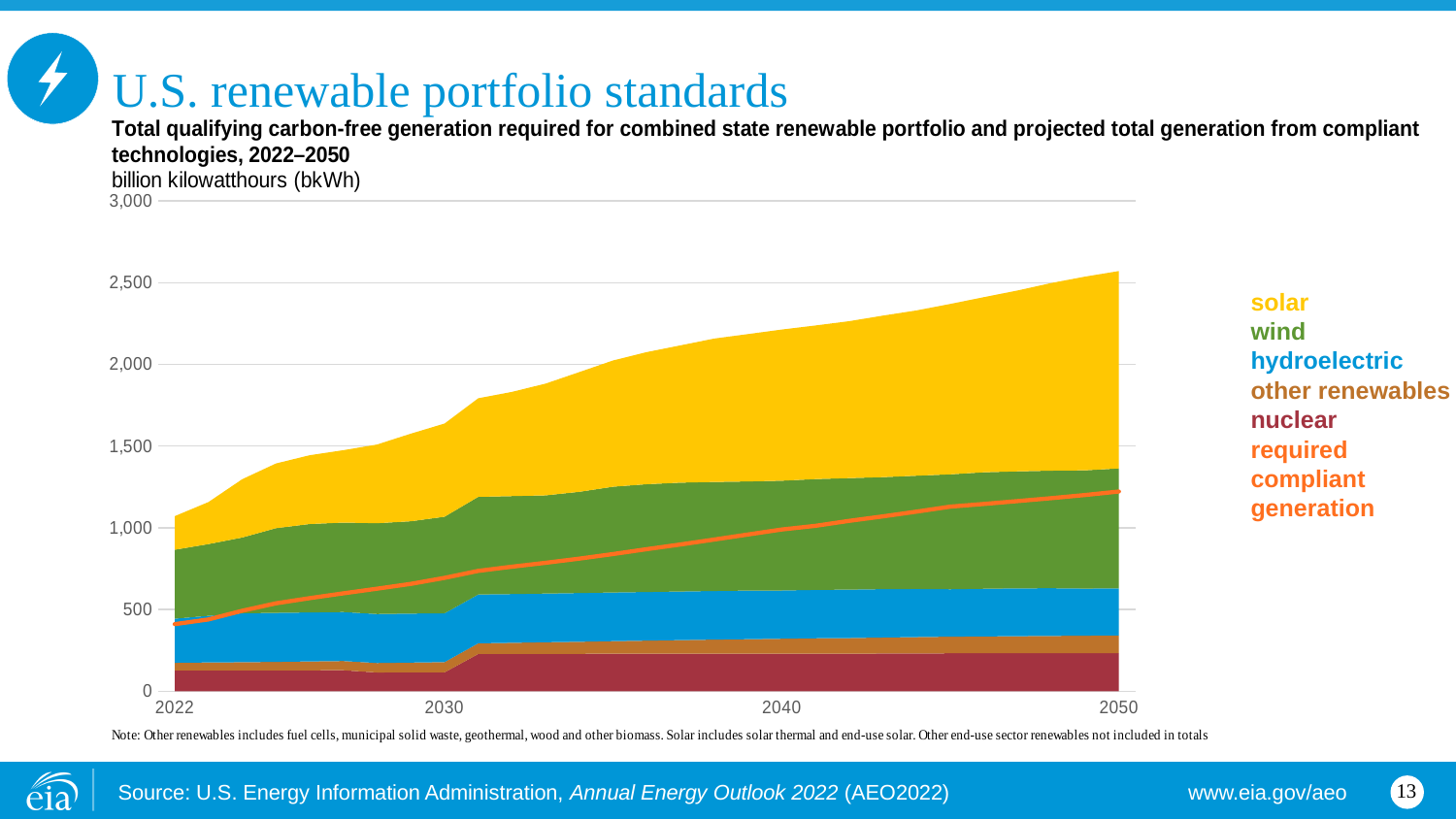
How many series does the legend list? 6 What kind of chart is shown on the slide? stacked area chart Is the total generation from compliant technologies in 2040 greater or less than 2,000? greater Is the total generation from compliant technologies in 2030 greater or less than 1,500? greater Does the total projected generation from compliant technologies rise or fall from 2022 to 2050? rise Is the value for required compliant generation in 2022 greater or less than 500? less Which series is drawn as a line rather than a shaded area? required compliant generation How many years are labeled on the x axis? 4 In 2050, which contributes more generation, solar or hydroelectric? solar What unit is the y axis measured in? billion kilowatthours (bkWh)